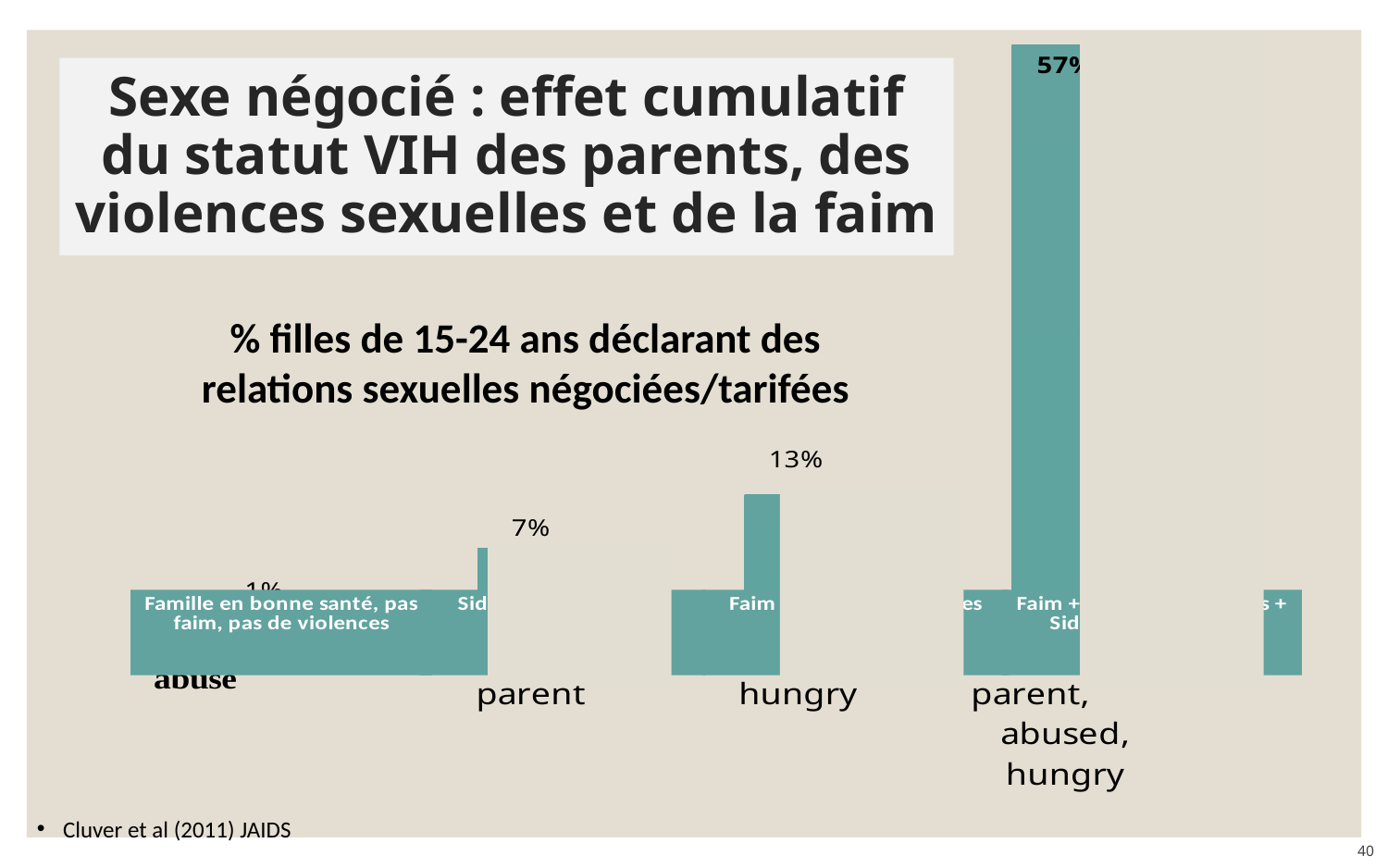
What is the value for the 'parent, abused, hungry' category? 57% Which category has the lowest value? Famille en bonne santé, pas faim, pas de violences What is the value for the 'parent' (Sida) category? 7% Which is larger, the value for 'hungry' or the value for 'parent'? hungry What is the value for the 'Famille en bonne santé, pas faim, pas de violences' category? 1% What is the difference between the 'hungry' value and the 'parent' value? 6 percentage points What does the chart's subtitle say is being measured? % filles de 15-24 ans déclarant des relations sexuelles négociées/tarifées What kind of chart is shown on the slide? bar chart What source is cited at the bottom of the slide? Cluver et al (2011) JAIDS Which category has the highest value? parent, abused, hungry What is the difference between the 'parent, abused, hungry' value and the 'hungry' value? 44 percentage points What is the value for the 'hungry' (Faim) category? 13%